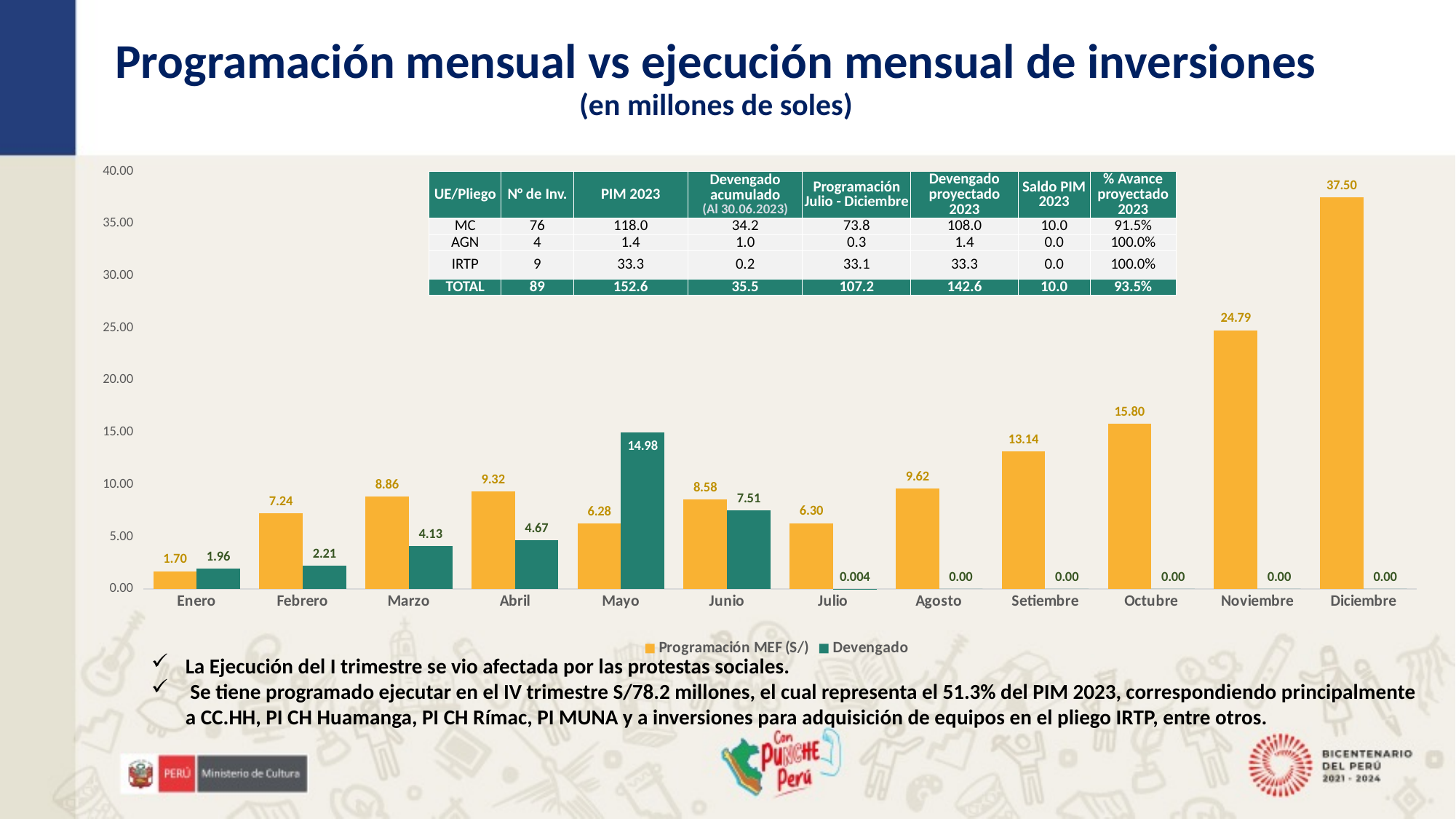
Is the Programación MEF (S/) value for Noviembre greater or less than 20.00? greater What is the Devengado value for Julio? 0.004 Which month has the highest Devengado value? Mayo What is the difference between the Devengado and Programación MEF (S/) values for Mayo? 8.70 What is the difference between the Programación MEF (S/) values for Diciembre and Noviembre? 12.71 How many series does the chart legend list? 2 What is the Programación MEF (S/) value for Diciembre? 37.50 How many months are shown on the x axis of the chart? 12 In Junio, which is larger: Programación MEF (S/) or Devengado? Programación MEF (S/) What is the Devengado value for Mayo? 14.98 Which month has the lowest Programación MEF (S/) value? Enero Which month has the highest Programación MEF (S/) value? Diciembre